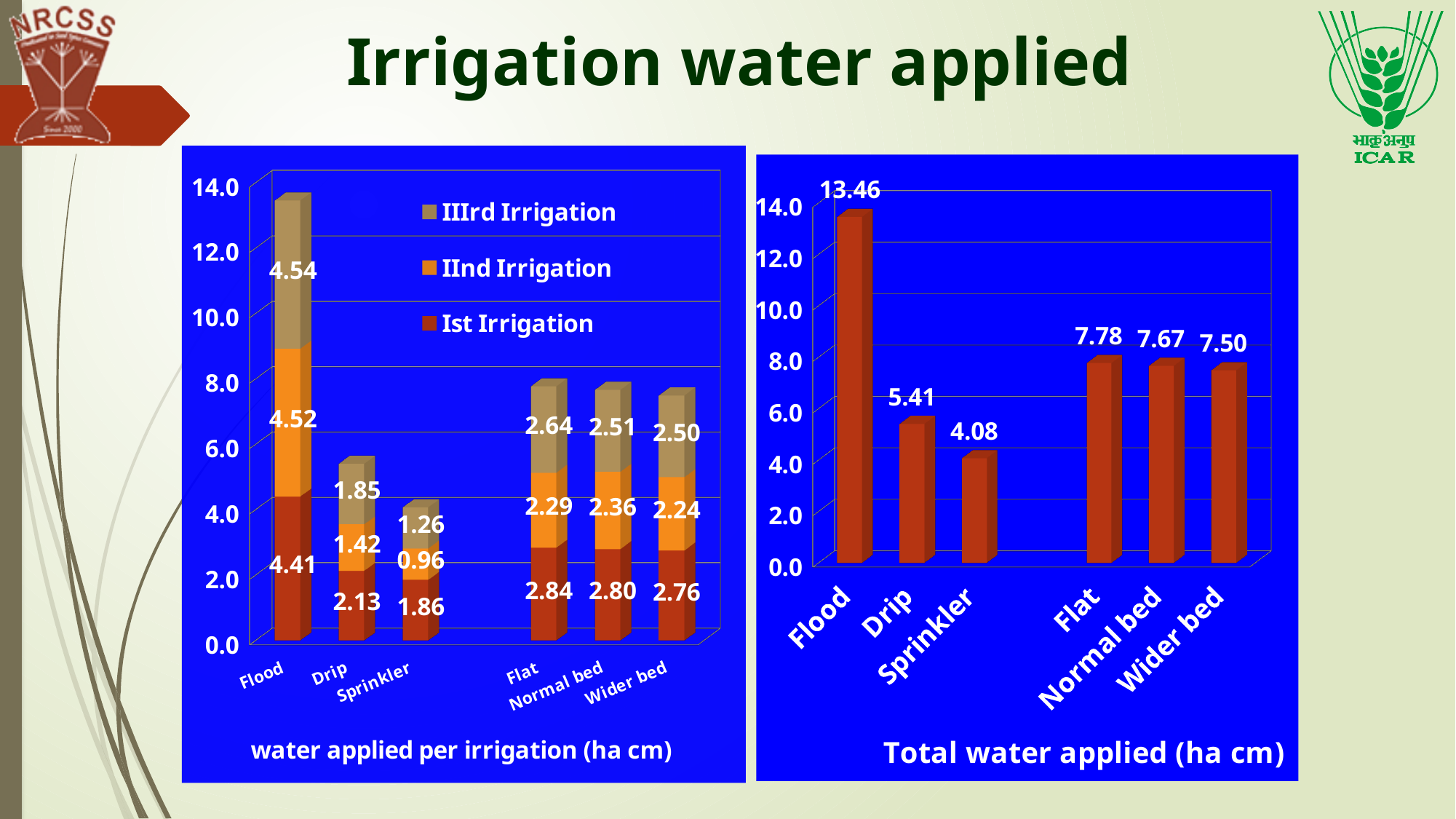
How many series does the legend of the 'water applied per irrigation (ha cm)' chart list? 3 In the 'Total water applied (ha cm)' chart, what is the value for Flood? 13.46 In the 'Total water applied (ha cm)' chart, what is the value for Sprinkler? 4.08 What kind of chart is the 'water applied per irrigation (ha cm)' chart? Stacked bar chart In the 'Total water applied (ha cm)' chart, which category has the lowest value? Sprinkler In the 'Total water applied (ha cm)' chart, which category has the highest value? Flood In the 'Total water applied (ha cm)' chart, what is the difference between Flood and Drip? 8.05 In the 'Total water applied (ha cm)' chart, is the value for Drip greater or less than 6.0? less In the 'water applied per irrigation (ha cm)' chart, what is the Ist Irrigation value for Drip? 2.13 In the 'water applied per irrigation (ha cm)' chart, what is the IIIrd Irrigation value for Wider bed? 2.50 How many categories are shown in the 'Total water applied (ha cm)' chart? 6 In the 'water applied per irrigation (ha cm)' chart, which is larger: the IInd Irrigation value for Flat or for Normal bed? Normal bed